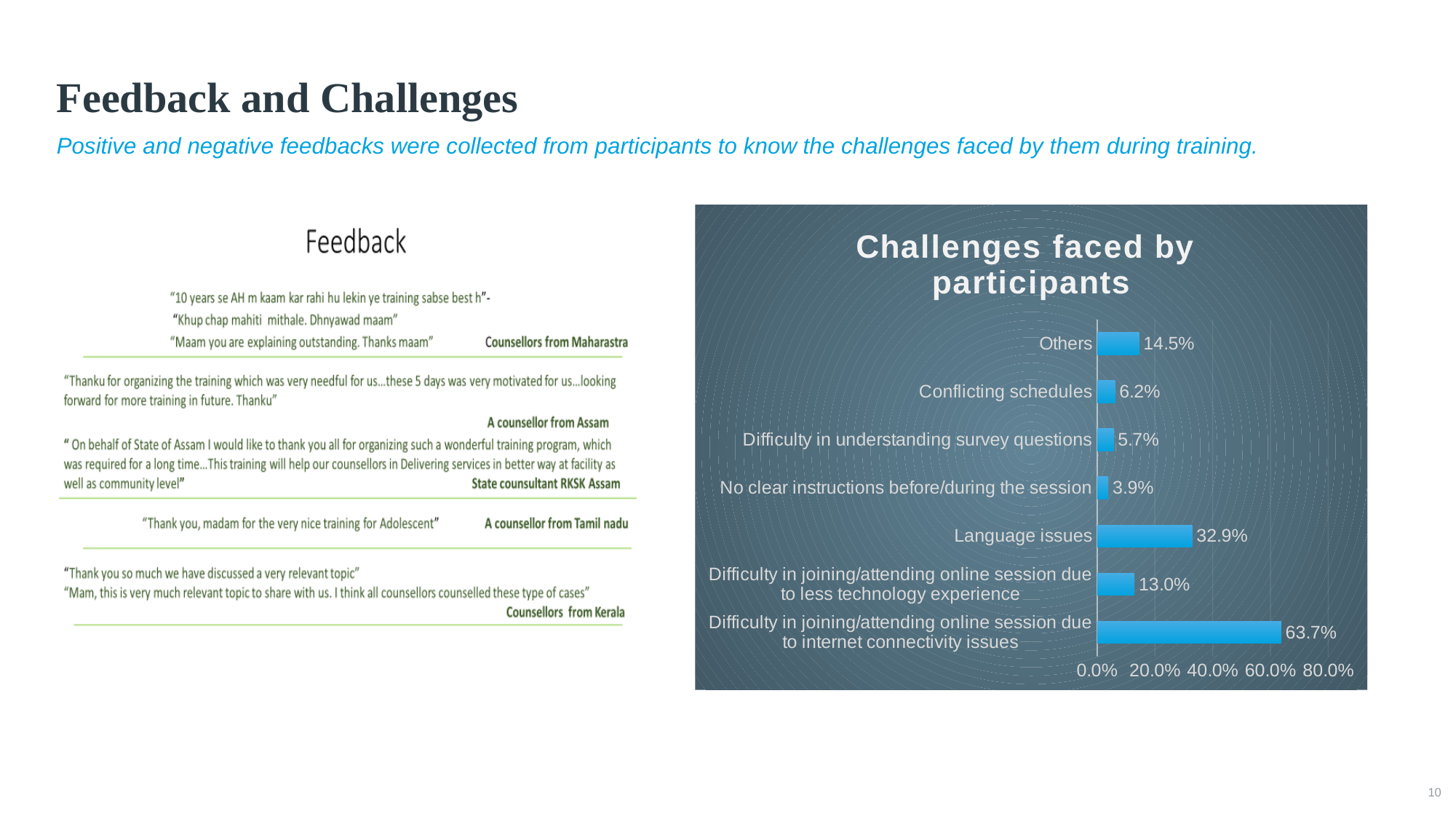
Which challenge has the lowest percentage in the chart? No clear instructions before/during the session What is the value for Difficulty in joining/attending online session due to internet connectivity issues? 63.7% What is the value for Language issues in the Challenges faced by participants chart? 32.9% Is the value for Language issues greater or less than 40.0%? less What percentage of participants reported Conflicting schedules as a challenge? 6.2% What is the value for Others in the Challenges faced by participants chart? 14.5% What is the difference between the values for Language issues and Difficulty in joining/attending online session due to less technology experience? 19.9% Which is larger: the value for Others or the value for Conflicting schedules? Others How many challenge categories are shown in the Challenges faced by participants chart? 7 What is the title of the chart on the right side of the slide? Challenges faced by participants What kind of chart is the Challenges faced by participants chart? bar chart Which challenge has the highest percentage in the chart? Difficulty in joining/attending online session due to internet connectivity issues